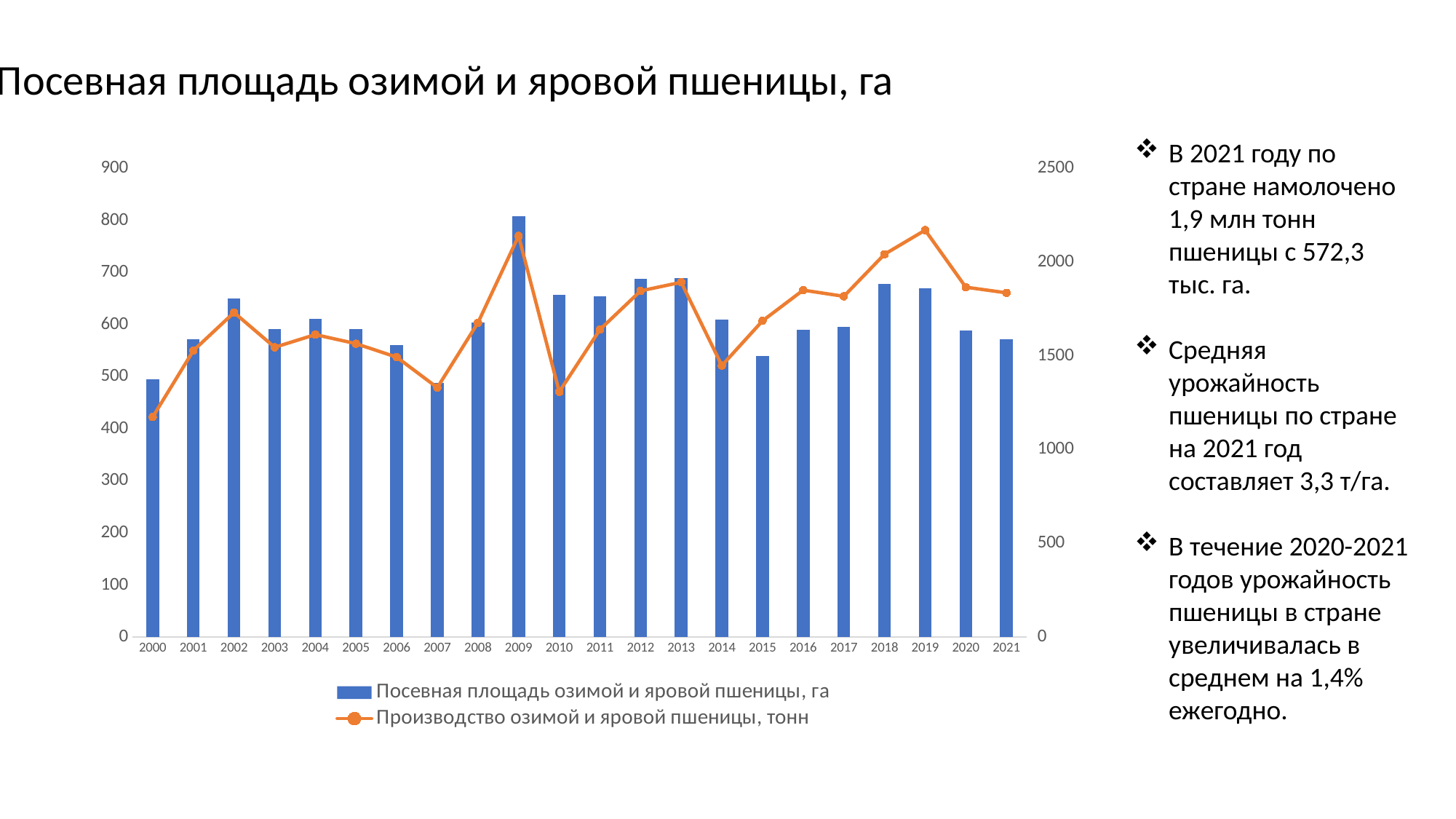
In which year does the line for Производство озимой и яровой пшеницы, тонн reach its highest point? 2019 Which year has the larger bar, 2009 or 2010? 2009 In which year is the bar for Посевная площадь озимой и яровой пшеницы, га the highest? 2009 What colour is the line for Производство озимой и яровой пшеницы, тонн? Orange Is the bar value for 2009 greater or less than 700 on the left axis? greater Is the line value for 2019 greater or less than 2000 on the right axis? greater Is the bar value for 2015 greater or less than 600 on the left axis? less What kind of chart is shown on the slide? A bar chart combined with a line chart How many years are shown along the x axis? 22 How many series does the legend list? 2 In which year is the bar for Посевная площадь озимой и яровой пшеницы, га the lowest? 2007 Do the bars rise or fall from 2000 to 2002? rise